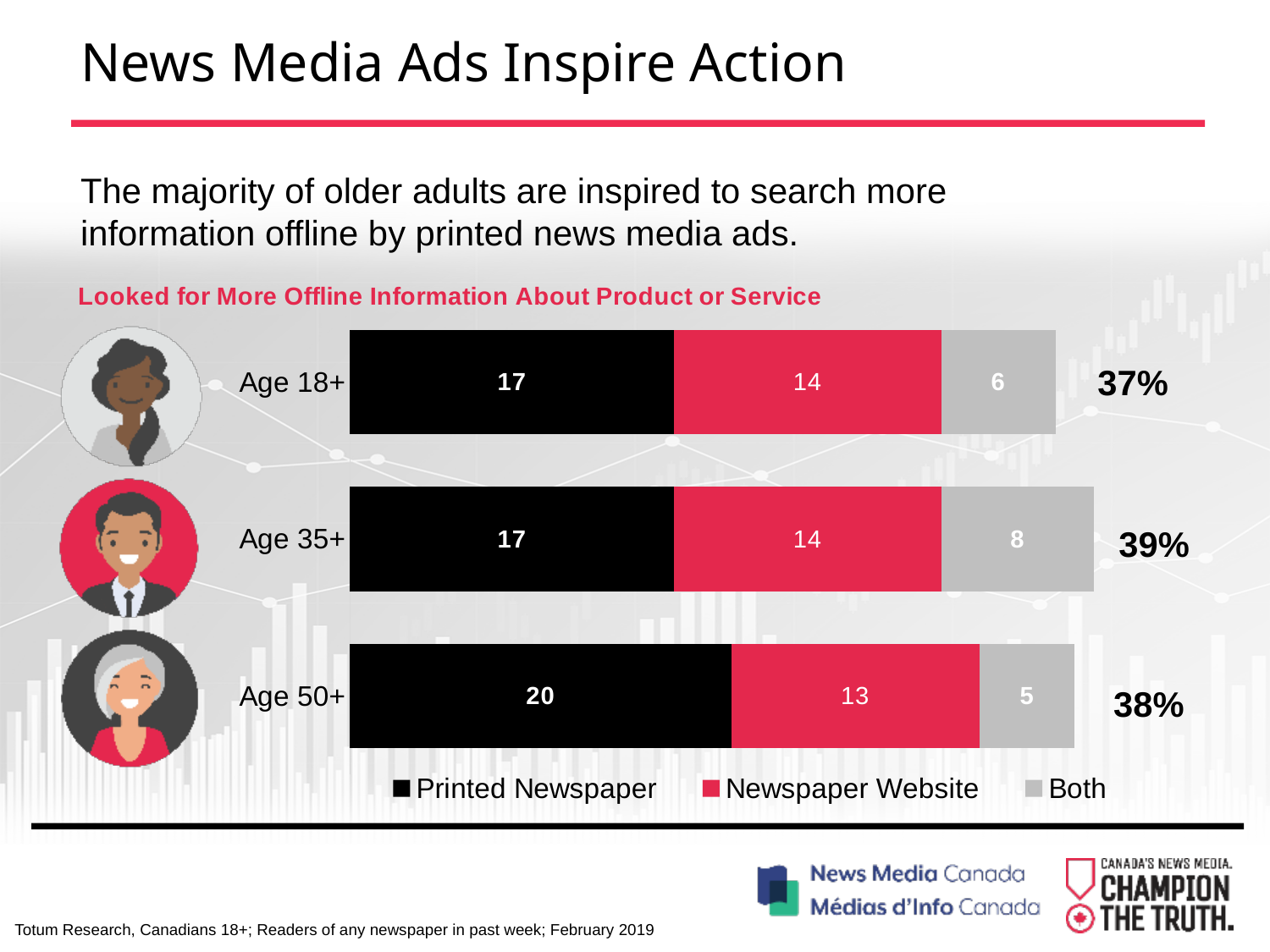
How many series does the legend list? 3 What is the total shown at the end of the Age 35+ bar? 39% What is the Newspaper Website value for Age 18+? 14 Which is larger for Age 50+: the Printed Newspaper value or the Newspaper Website value? Printed Newspaper How many age groups are shown in the chart? 3 What is the Both value for Age 35+? 8 Which age group has the lowest Both value? Age 50+ Which age group has the highest Printed Newspaper value? Age 50+ What is the difference between the Printed Newspaper values for Age 50+ and Age 18+? 3 What is the Printed Newspaper value for Age 50+? 20 What kind of chart is shown on the slide? Stacked bar chart What is the title of the chart? Looked for More Offline Information About Product or Service